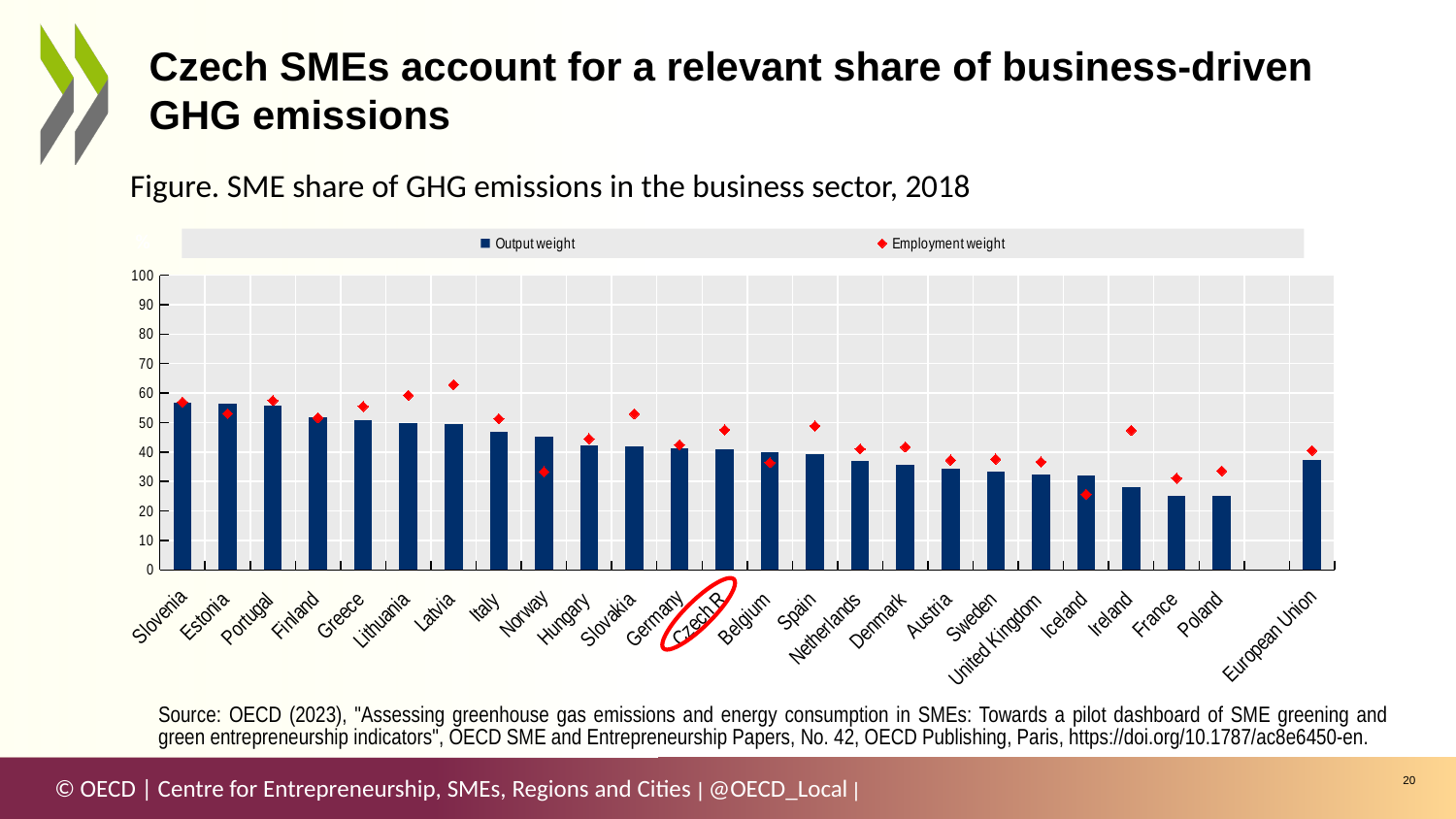
Which country's label is circled in red on the chart? Czech R. What kind of chart is shown on the slide? bar chart Which country has the lowest Employment weight value in the chart? Iceland Do the Output weight bars generally rise or fall from left to right across the countries? fall Is the Employment weight value for Czech R. greater or less than 40? greater Which has the larger Output weight value, Czech R. or Ireland? Czech R. Is the Output weight value for Slovenia greater or less than 50? greater Is the Output weight value for Poland greater or less than 30? less Which country has the highest Employment weight value in the chart? Latvia How many countries/regions are shown on the x axis of the chart? 25 How many series does the chart legend list? 2